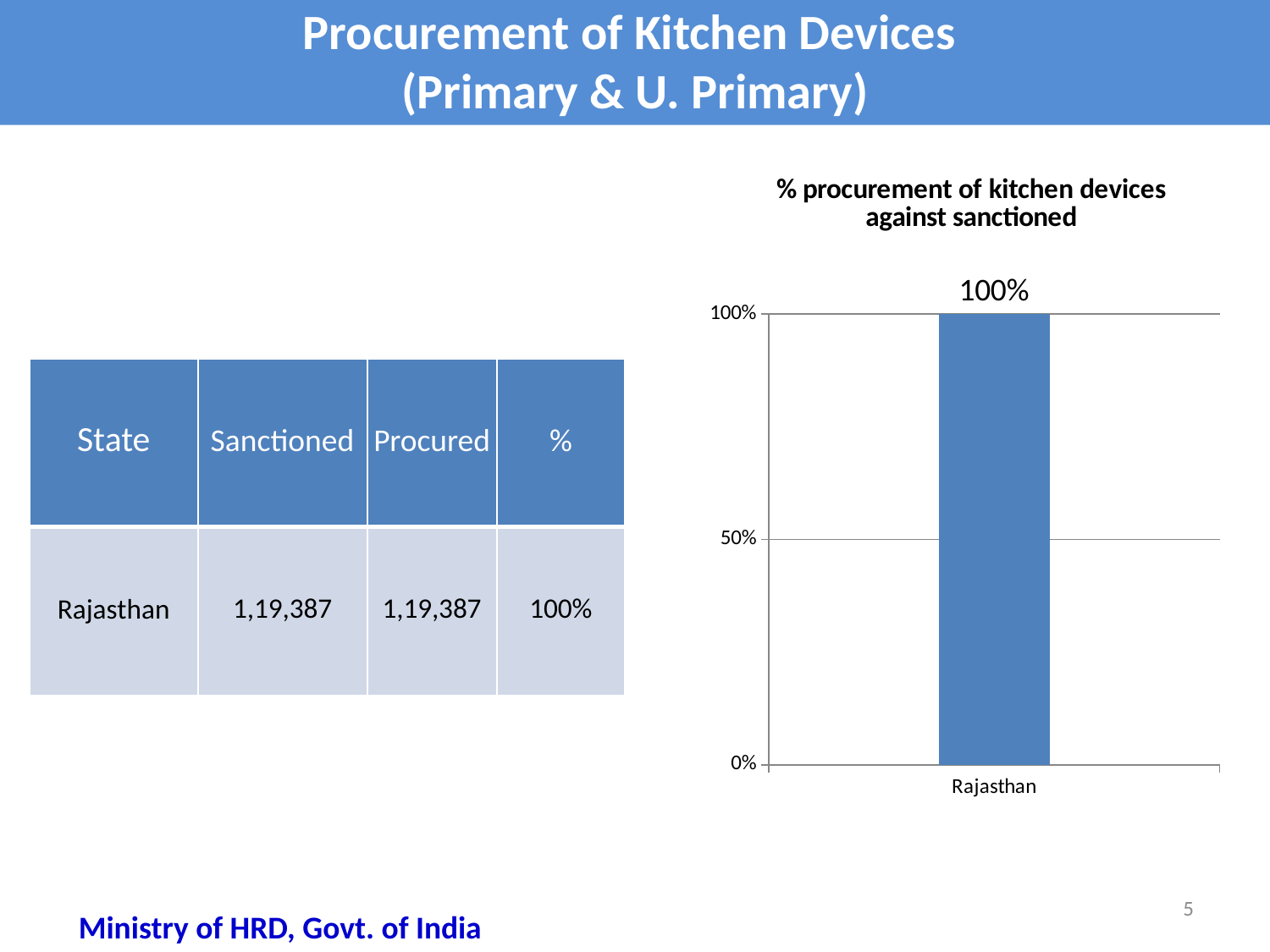
How many categories are plotted in the chart? 1 Is the value for Rajasthan greater or less than 50%? greater What is the title of the chart? % procurement of kitchen devices against sanctioned Which category is shown on the x axis of the chart? Rajasthan What is the value for Rajasthan in the chart? 100% What is the highest value shown on the chart's y axis? 100% What kind of chart is shown on the slide? bar chart